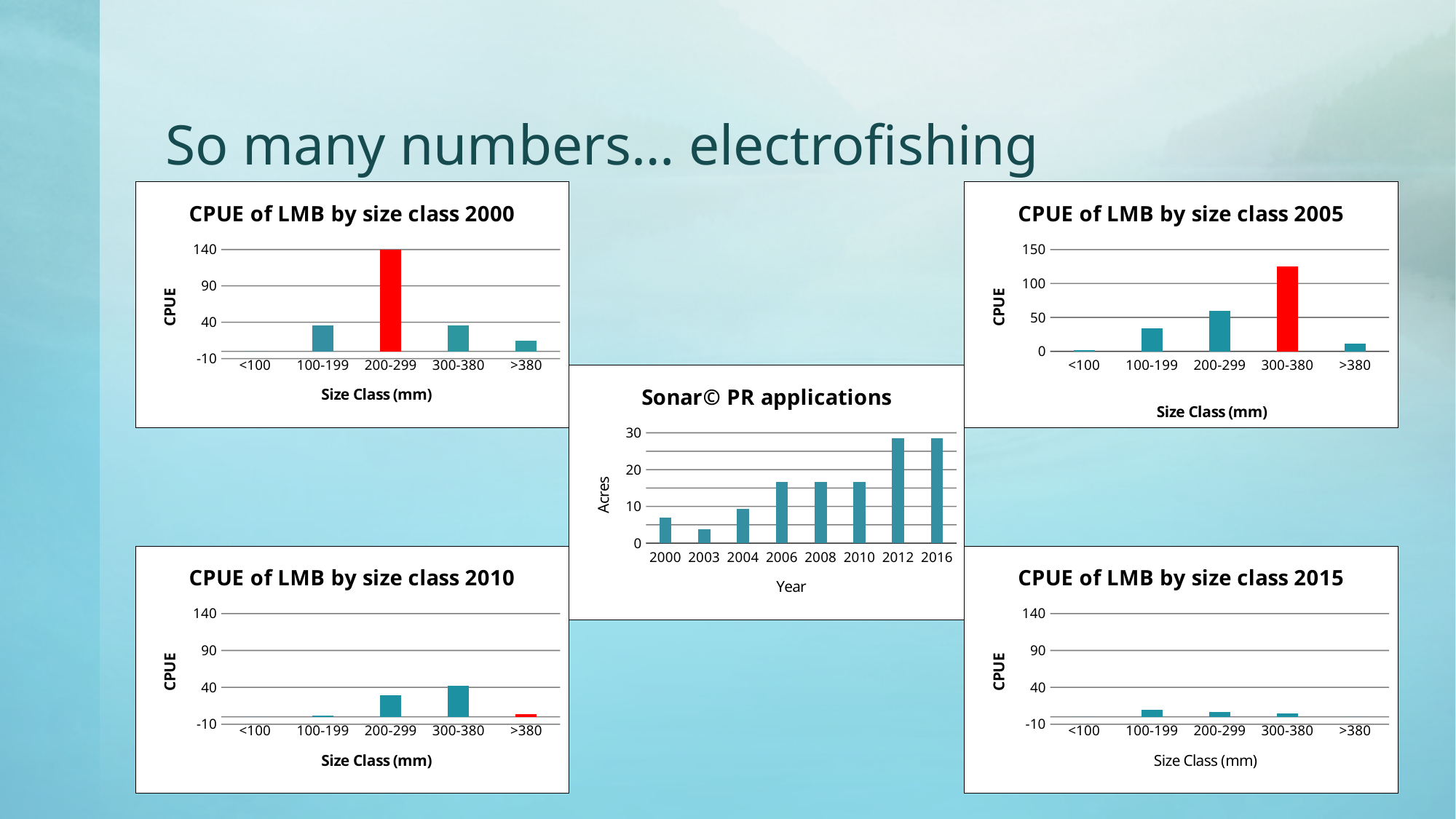
In the chart titled 'CPUE of LMB by size class 2000', which size class is drawn with a red bar? 200-299 In the chart titled 'CPUE of LMB by size class 2000', is the value for 200-299 greater or less than 90? greater In the chart titled 'Sonar© PR applications', which year has the lowest acres? 2003 In the chart titled 'CPUE of LMB by size class 2005', is the value for 200-299 greater or less than 50? greater What kind of chart is the one titled 'Sonar© PR applications'? bar chart In the chart titled 'Sonar© PR applications', how many years are shown on the x axis? 8 In the chart titled 'CPUE of LMB by size class 2005', which size class has the highest CPUE? 300-380 In the chart titled 'CPUE of LMB by size class 2000', which size class has the highest CPUE? 200-299 In the chart titled 'CPUE of LMB by size class 2005', which has the larger CPUE, 100-199 or 200-299? 200-299 In the chart titled 'CPUE of LMB by size class 2010', which size class has the highest CPUE? 300-380 In the chart titled 'Sonar© PR applications', is the value for 2012 greater or less than 20? greater